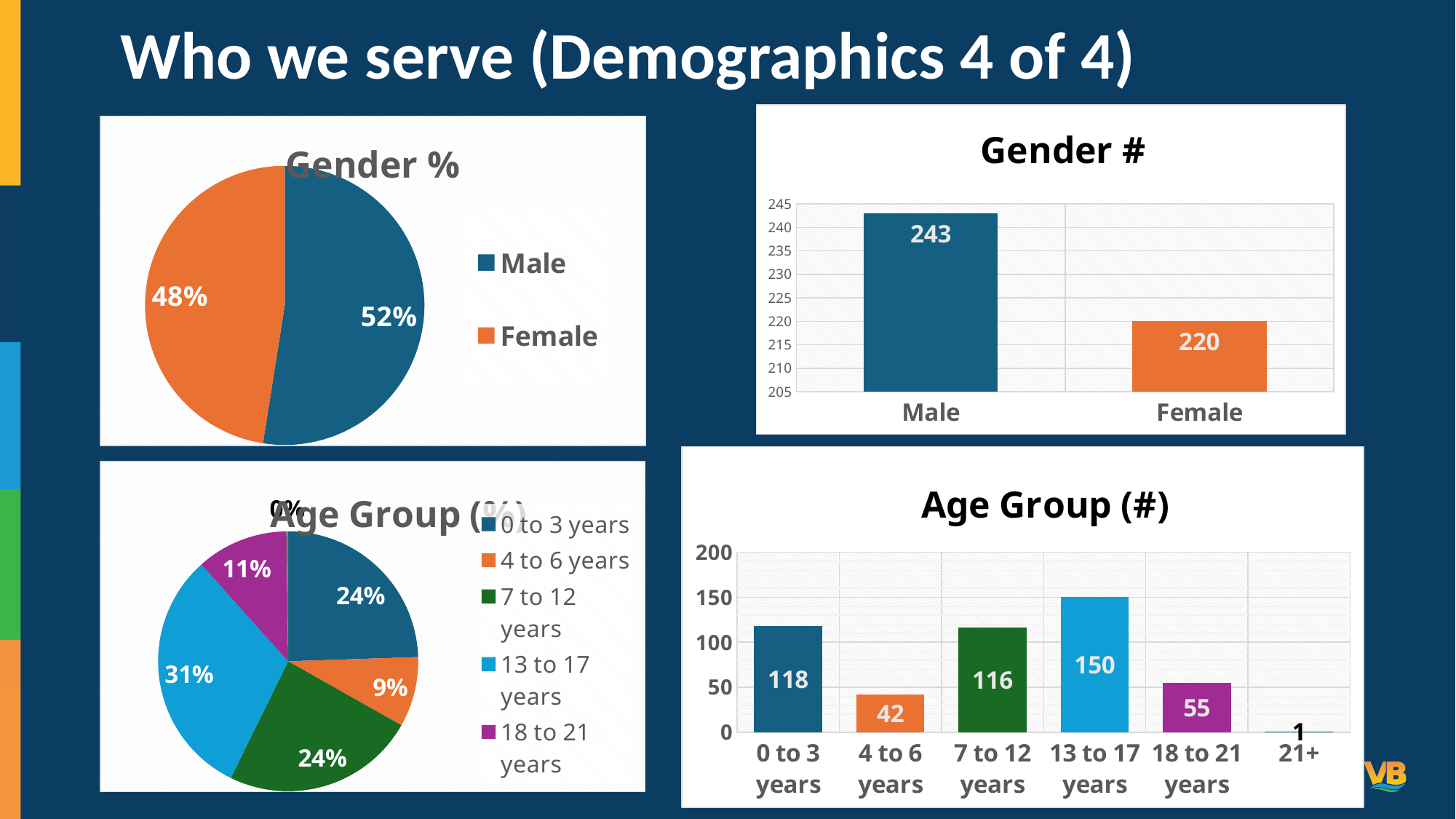
In the Age Group (#) chart, what is the value for 4 to 6 years? 42 In the Gender # chart, what is the difference between the Male and Female values? 23 In the Gender % pie chart, what share is Male? 52% In the Age Group (%) pie chart, what share is 13 to 17 years? 31% What kind of chart is the Gender # chart? bar chart In the Age Group (#) chart, which is larger, the value for 0 to 3 years or the value for 18 to 21 years? 0 to 3 years In the Age Group (#) chart, which age group has the lowest value? 21+ In the Gender # chart, what is the value for Male? 243 In the Age Group (#) chart, how many age group categories are shown on the x axis? 6 In the Gender # chart, what is the value for Female? 220 In the Gender % pie chart, what share is Female? 48% In the Age Group (#) chart, which age group has the highest value? 13 to 17 years